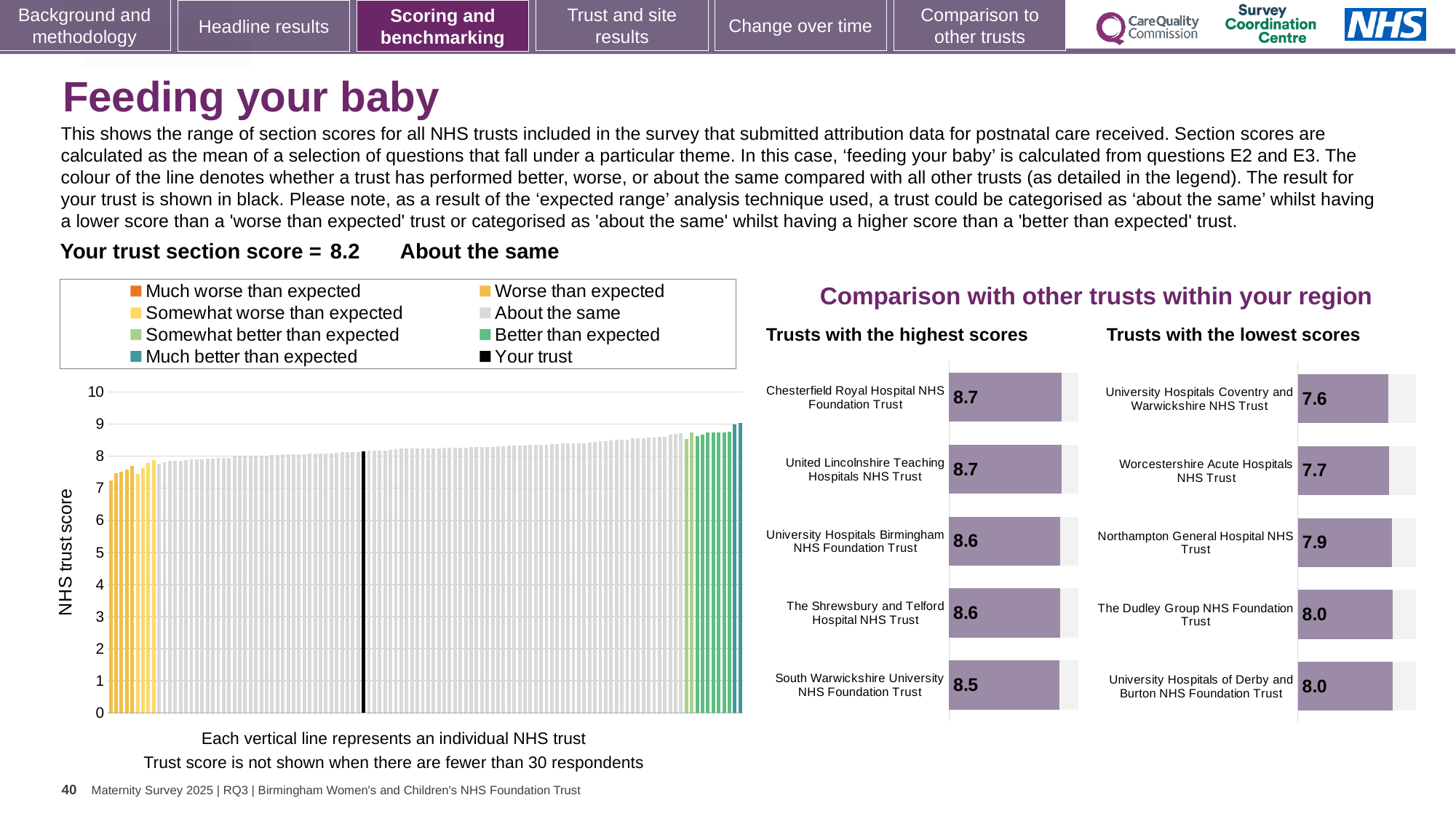
How many entries does the legend above the 'NHS trust score' chart list? 8 In the 'Trusts with the lowest scores' chart, which trust has the lowest score? University Hospitals Coventry and Warwickshire NHS Trust In the 'Trusts with the lowest scores' chart, what is the difference between the scores of University Hospitals of Derby and Burton NHS Foundation Trust and University Hospitals Coventry and Warwickshire NHS Trust? 0.4 In the 'Trusts with the highest scores' chart, what is the difference between the scores of Chesterfield Royal Hospital NHS Foundation Trust and South Warwickshire University NHS Foundation Trust? 0.2 In the 'Trusts with the highest scores' chart, what is the score for Chesterfield Royal Hospital NHS Foundation Trust? 8.7 In the 'NHS trust score' chart, is the value of the black 'Your trust' bar greater or less than 5? greater How many trusts are shown in the 'Trusts with the highest scores' chart? 5 What kind of chart is the large 'NHS trust score' chart on the left of the slide? Bar chart In the 'Trusts with the lowest scores' chart, what is the score for University Hospitals Coventry and Warwickshire NHS Trust? 7.6 In the 'Trusts with the lowest scores' chart, which has the higher score: Northampton General Hospital NHS Trust or Worcestershire Acute Hospitals NHS Trust? Northampton General Hospital NHS Trust In the 'NHS trust score' chart, do the bar values rise or fall from left to right? Rise In the 'Trusts with the highest scores' chart, which trust has the lowest score? South Warwickshire University NHS Foundation Trust